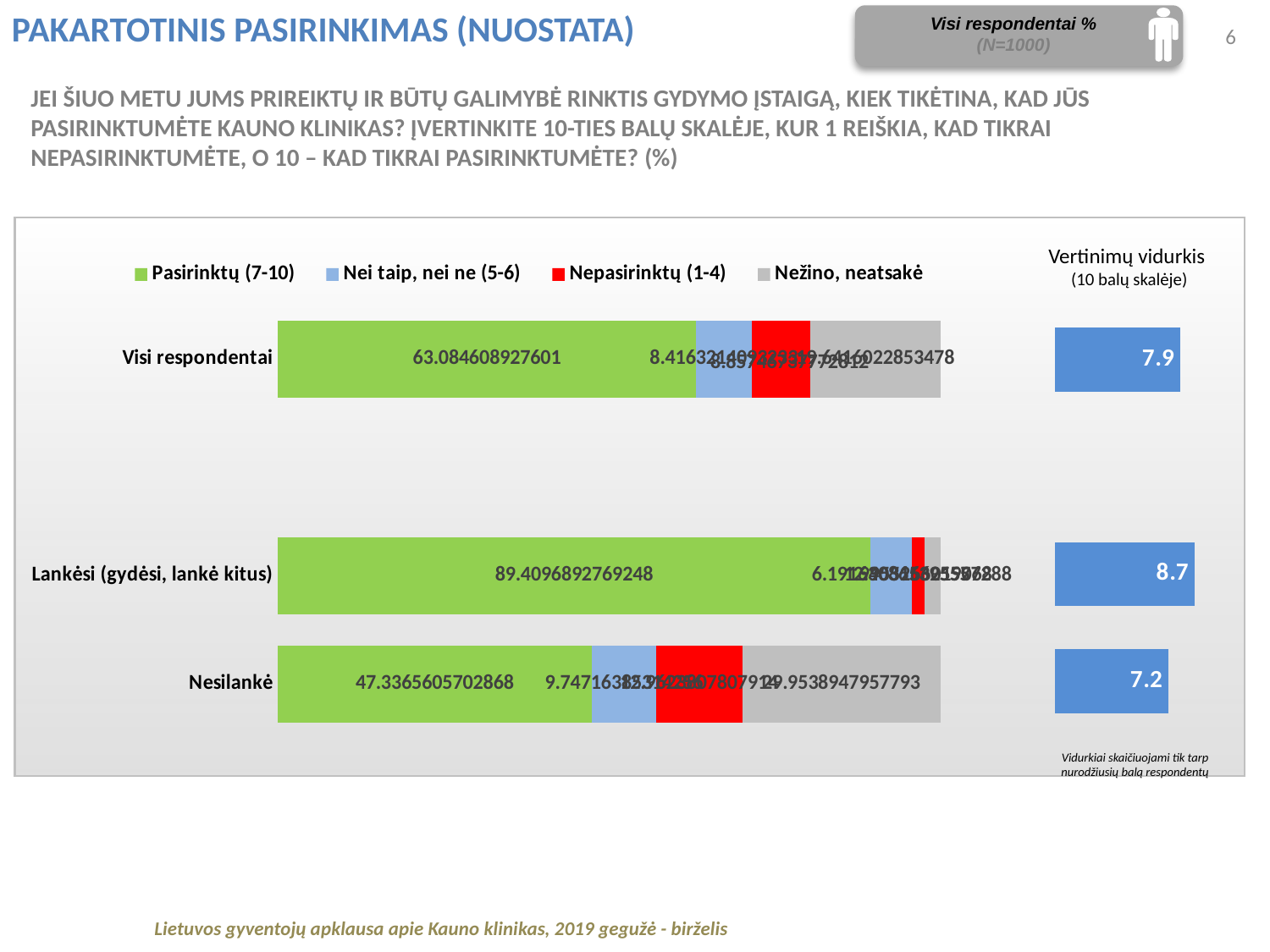
In the stacked bar chart on the left, which category has the lowest Pasirinktų (7-10) value? Nesilankė In the stacked bar chart on the left, what colour represents the Nepasirinktų (1-4) series? red In the Vertinimų vidurkis chart on the right, what is the difference between the average scores of Lankėsi (gydėsi, lankė kitus) and Nesilankė? 1.5 In the stacked bar chart on the left, which category has the highest Pasirinktų (7-10) value? Lankėsi (gydėsi, lankė kitus) In the stacked bar chart on the left, which has the larger Pasirinktų (7-10) value: Visi respondentai or Nesilankė? Visi respondentai In the stacked bar chart on the left, how many categories (respondent groups) are plotted? 3 In the stacked bar chart on the left, what is the value of Pasirinktų (7-10) for Visi respondentai? 63.084608927601 What kind of chart is the main chart on the left showing the response distribution? bar chart In the Vertinimų vidurkis chart on the right, what is the average score for Lankėsi (gydėsi, lankė kitus)? 8.7 In the stacked bar chart on the left, what is the value of Pasirinktų (7-10) for Nesilankė? 47.3365605702868 In the stacked bar chart on the left, what is the value of Pasirinktų (7-10) for Lankėsi (gydėsi, lankė kitus)? 89.4096892769248 In the stacked bar chart on the left, how many series does the legend list? 4